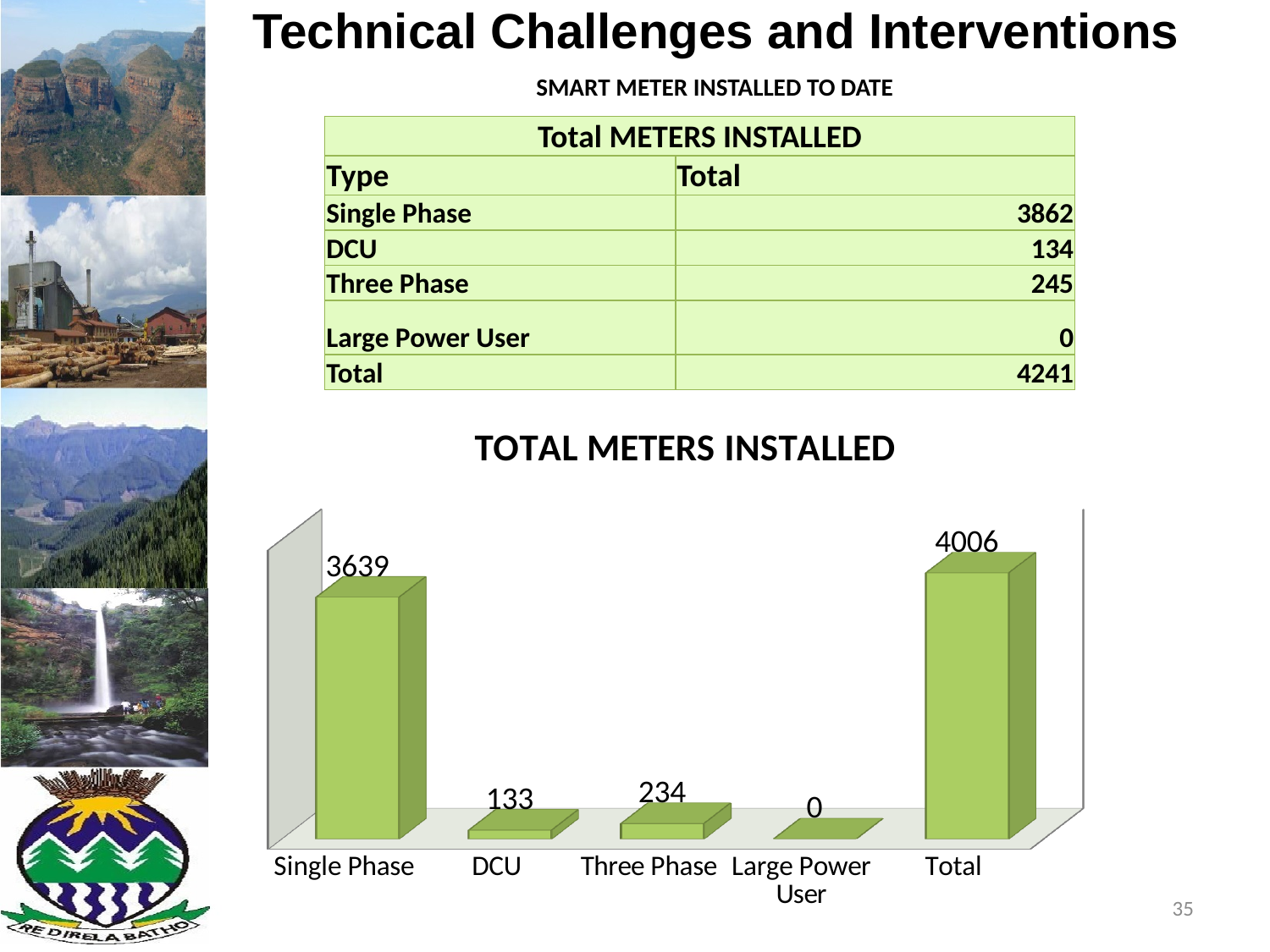
In the chart, what is the difference between the Single Phase value and the Three Phase value? 3405 In the chart, what value is shown for DCU? 133 In the chart, excluding the Total bar, which category has the highest value? Single Phase In the chart, what value is shown for Large Power User? 0 In the chart, what is the difference between the Three Phase value and the DCU value? 101 What type of chart is shown on the slide? Bar chart In the chart, what value is shown for the Total bar? 4006 In the chart, what value is shown for Single Phase? 3639 How many bars are plotted in the chart? 5 In the chart, which is larger, the value for DCU or the value for Three Phase? Three Phase In the chart, what value is shown for Three Phase? 234 In the chart, which category has the lowest value? Large Power User